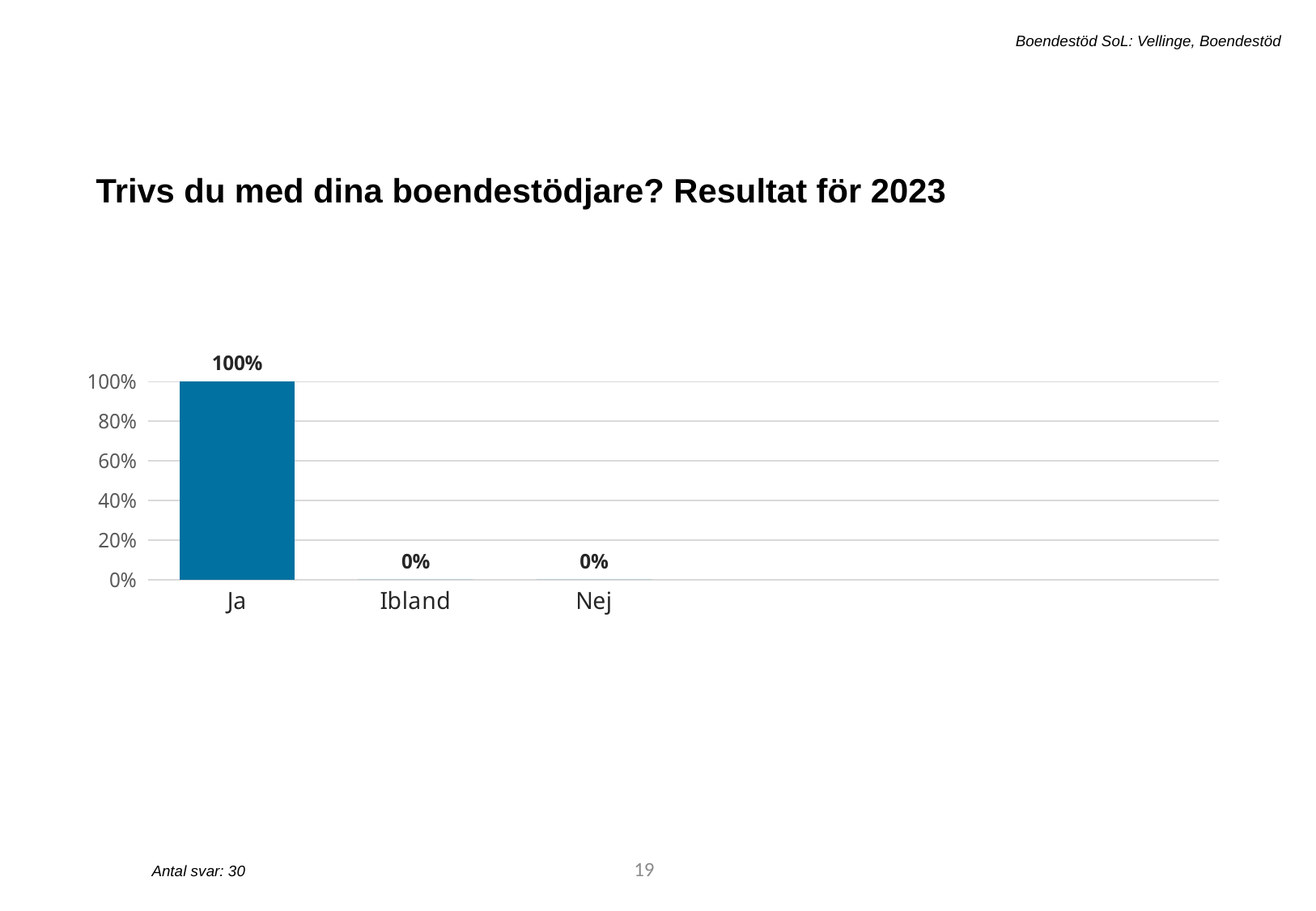
What is the value for Ibland? 0% Which is larger, the value for Ja or the value for Ibland? Ja What kind of chart is shown on the slide? bar chart What is the title of the chart? Trivs du med dina boendestödjare? Resultat för 2023 What is the value for Nej? 0% What is the value for Ja? 100% What is the highest value shown on the y axis? 100% What is the total of the values for Ja, Ibland and Nej? 100% How many categories are shown on the x axis? 3 Is the value for Ja greater or less than 80%? greater Which category has the highest value? Ja What is the difference between the values for Ja and Nej? 100%